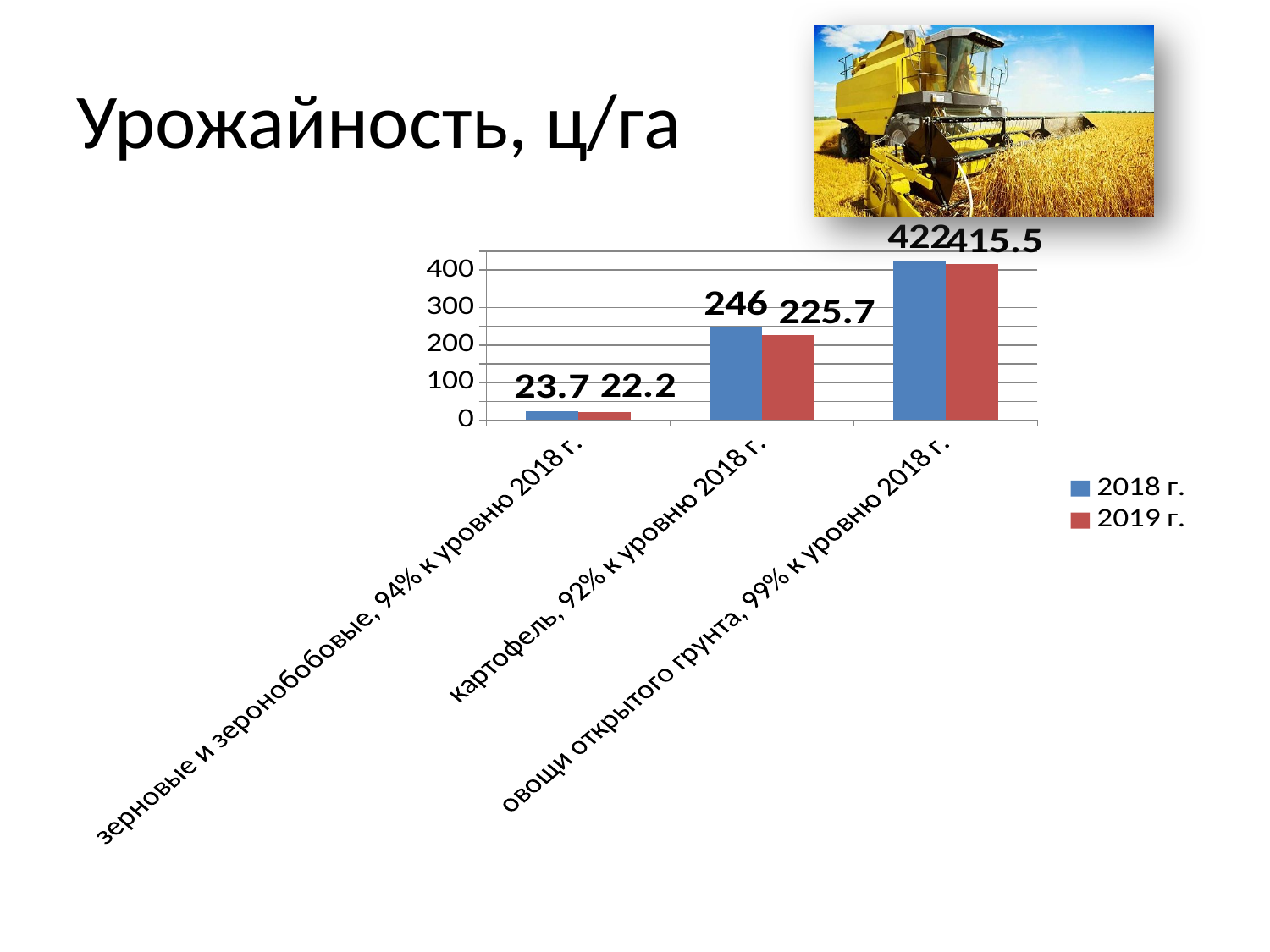
What is the difference between the 2018 г. and 2019 г. values for картофель? 20.3 What is the 2018 г. value for картофель? 246 Which is larger for овощи открытого грунта: the 2018 г. value or the 2019 г. value? 2018 г. What is the 2019 г. value for картофель? 225.7 Which category has the lowest 2019 г. value? зерновые и зеронобобовые Which colour represents the 2019 г. series in the legend? red How many categories are shown on the x axis? 3 What type of chart is shown on the slide? bar chart What is the 2019 г. value for овощи открытого грунта? 415.5 What is the 2018 г. value for зерновые и зеронобобовые? 23.7 How many series does the legend list? 2 Which category has the highest 2018 г. value? овощи открытого грунта